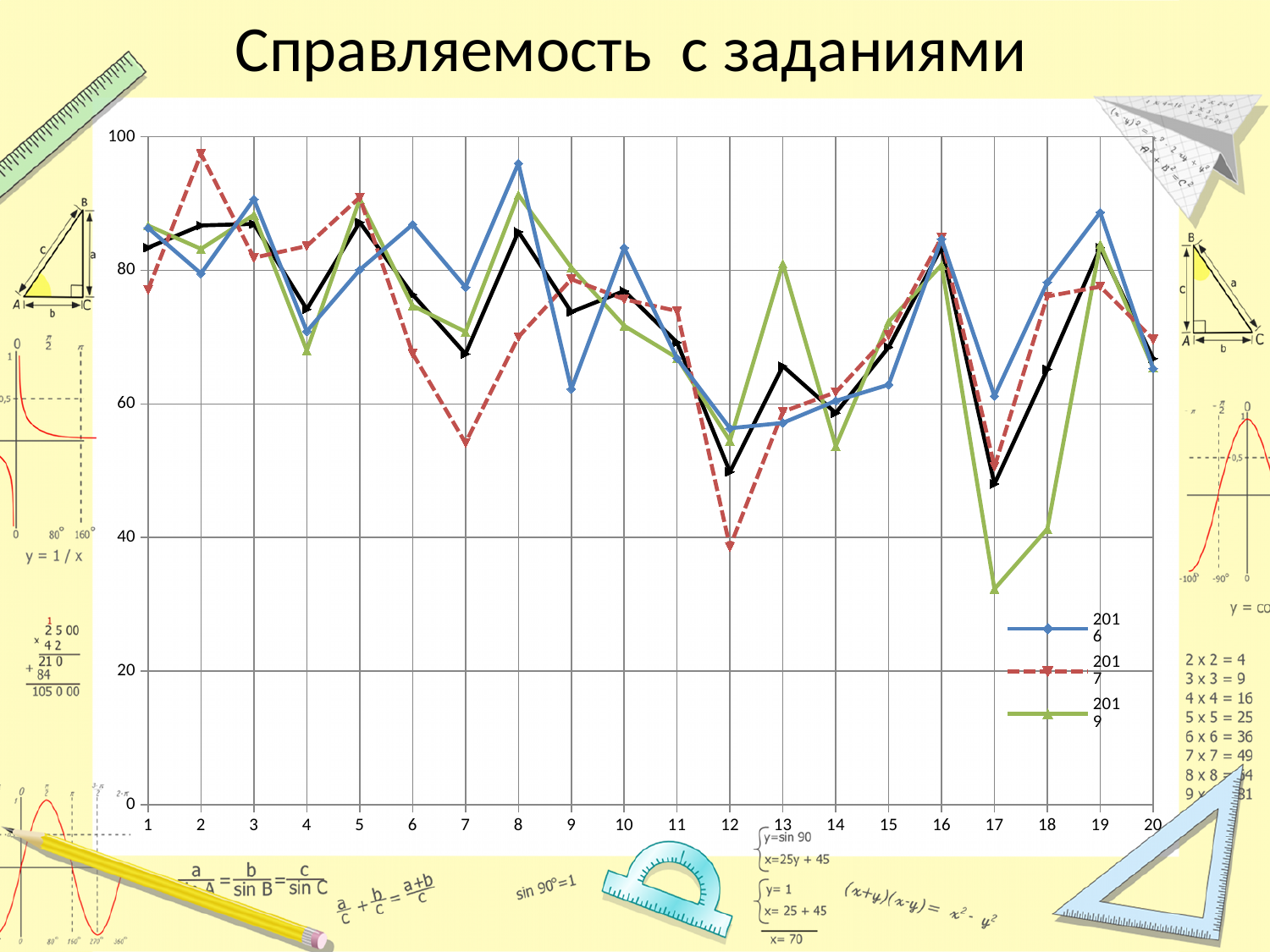
Is the value of the 2016 series at point 8 greater or less than 80? greater At which point does the 2016 series reach its highest value? 8 What kind of chart is shown on the slide? line chart Is the value of the 2019 series at point 17 greater or less than 40? less How many points are there along the x axis? 20 Between point 16 and point 17, does the 2019 series rise or fall? fall Is the value of the 2017 series at point 7 greater or less than 60? less At point 17, which series has the larger value, 2016 or 2019? 2016 Which series is drawn with a red dashed line? 2017 What is the title of the chart? Справляемость с заданиями How many series does the legend list? 3 At which point does the 2019 series reach its lowest value? 17